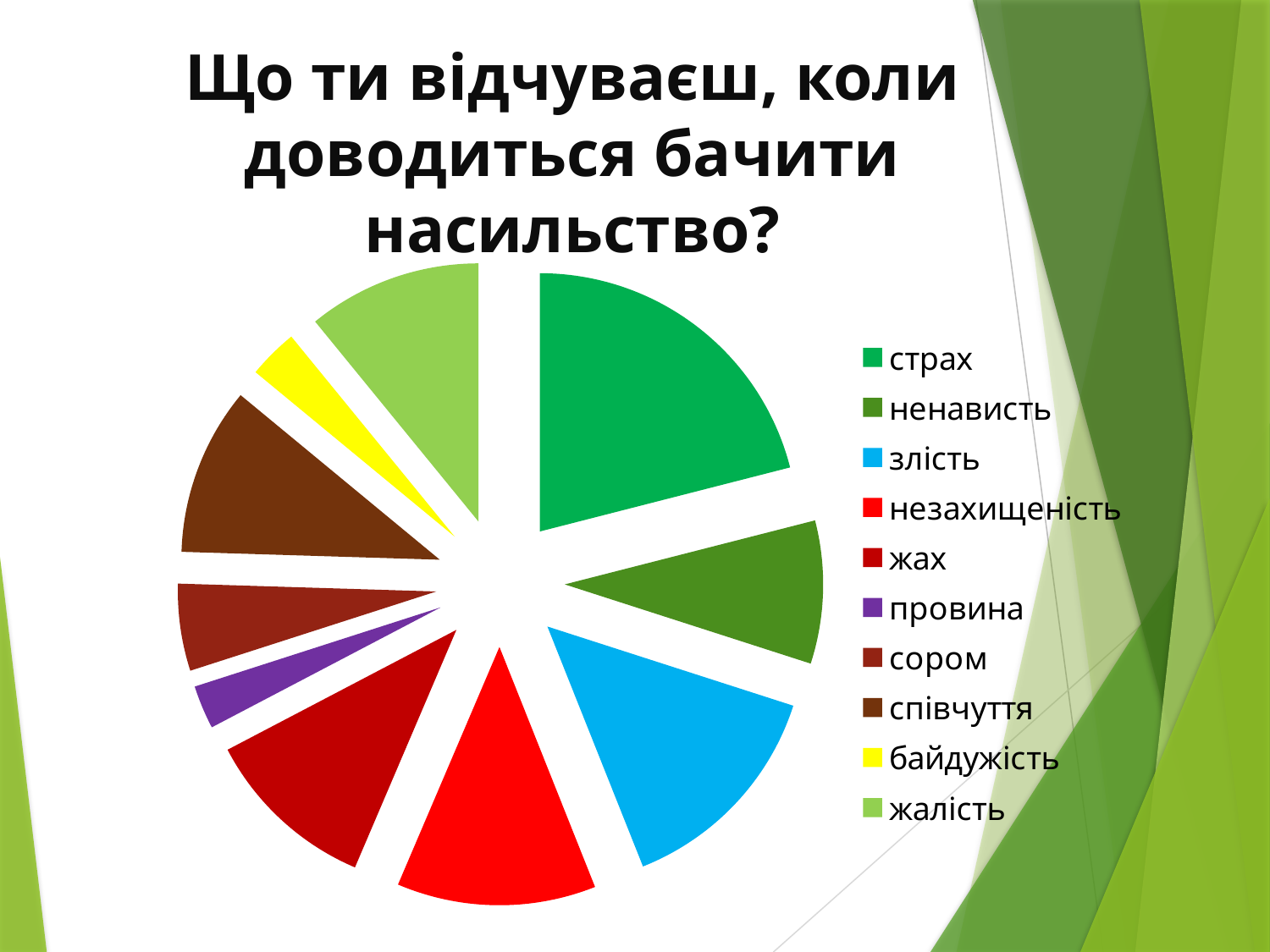
Which slice is larger, провина or жалість? жалість Which slice is larger, ненависть or байдужість? ненависть How many entries does the legend of the pie chart list? 10 How many categories (slices) does the pie chart have? 10 What kind of chart is shown on the slide? pie chart Which slice is larger, жах or провина? жах Which category has the smallest slice of the pie? провина Which category has the largest slice of the pie? страх What is the title of the slide above the pie chart? Що ти відчуваєш, коли доводиться бачити насильство?